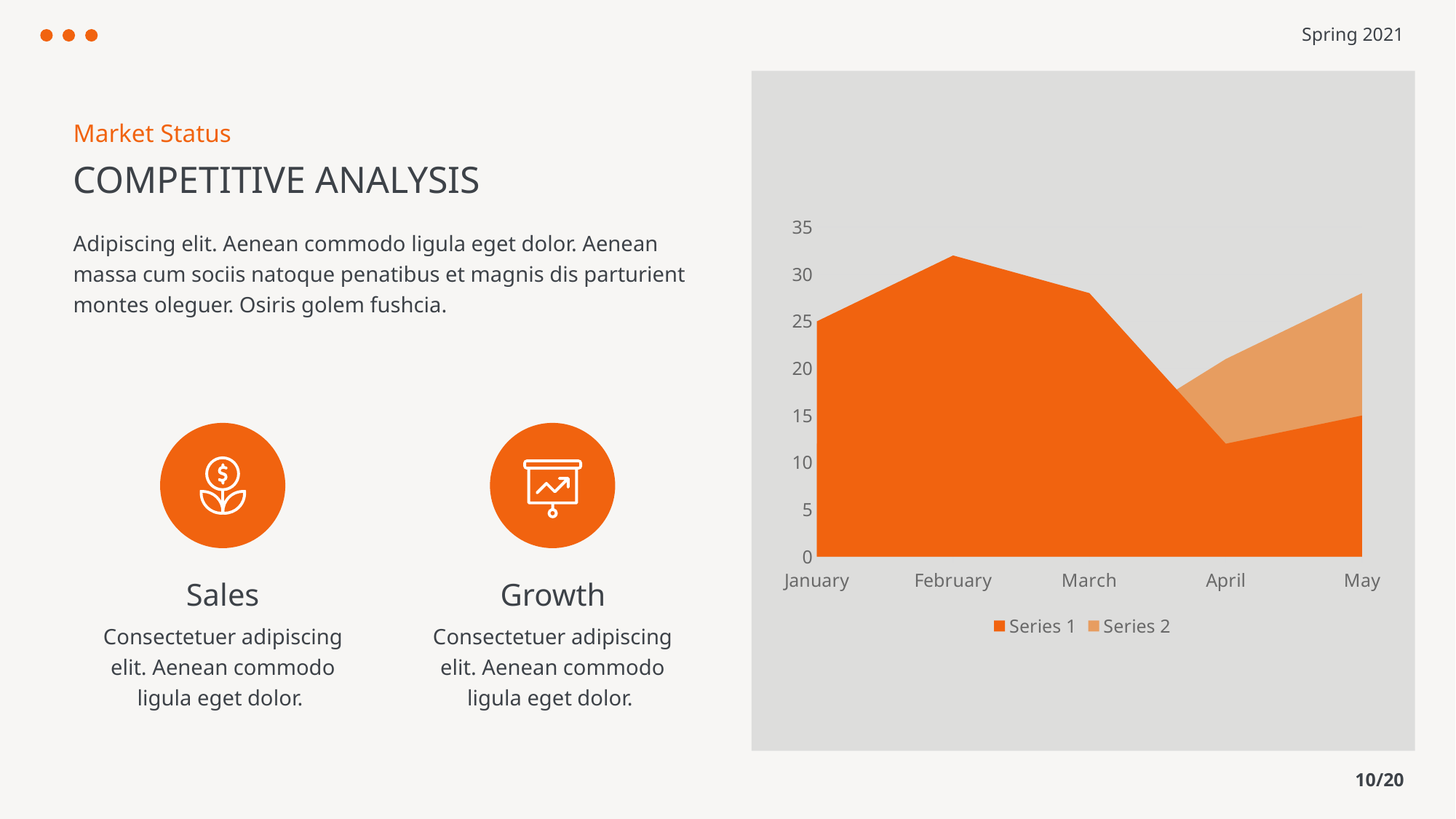
Is the value of Series 1 in April greater or less than 15? less Does Series 1 rise or fall from February to April? fall Is the value of Series 2 in May greater or less than 25? greater In which month does Series 1 reach its highest value? February Which is larger for Series 1: the value in February or the value in March? February What are the two entries listed in the chart legend? Series 1 and Series 2 Is the value of Series 1 in February greater or less than 30? greater What kind of chart is shown on the slide? area chart In May, which series has the larger value, Series 1 or Series 2? Series 2 How many months are shown on the x axis of the chart? 5 How many series does the chart legend list? 2 In which month does Series 1 reach its lowest value? April